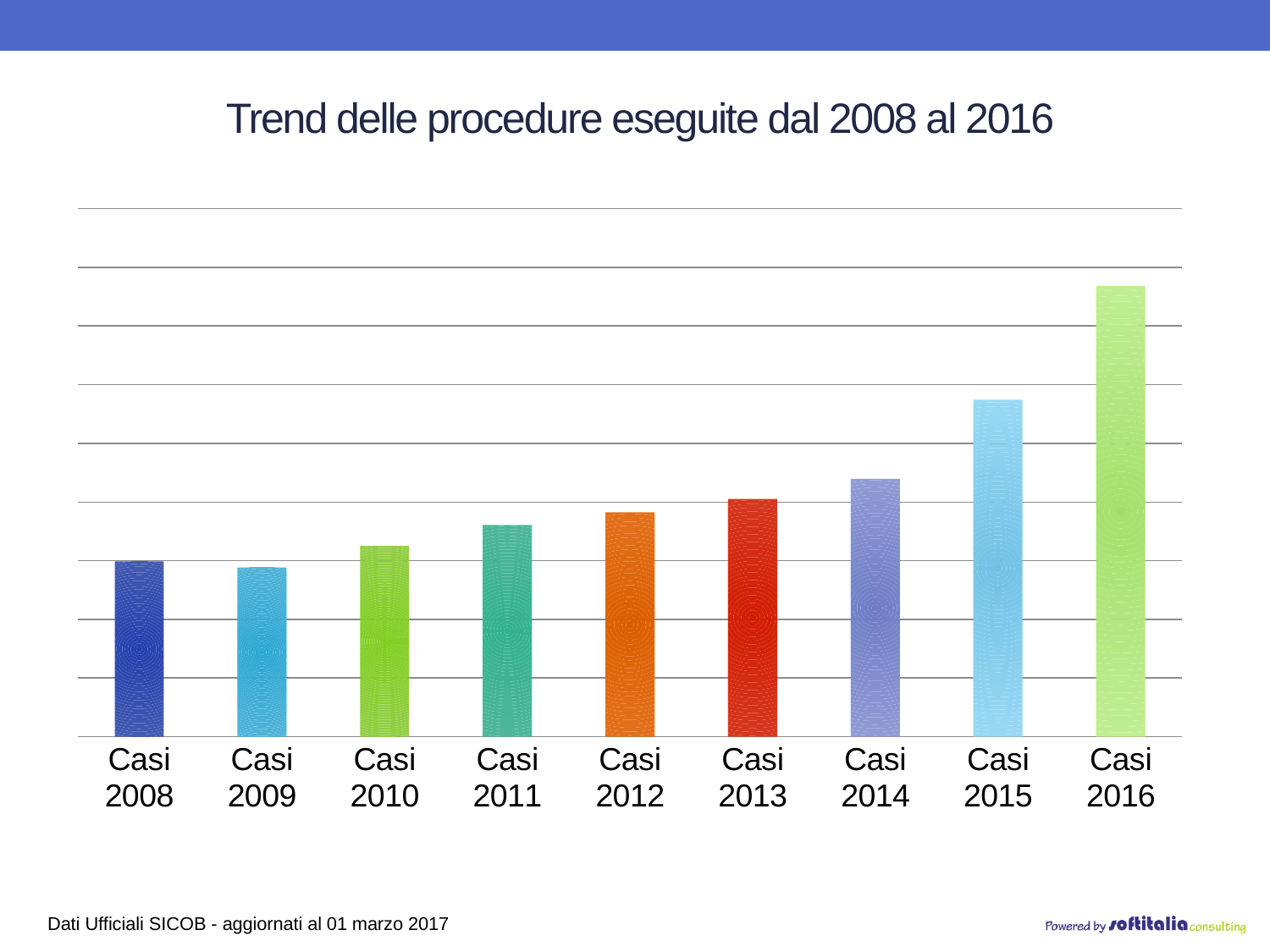
What kind of chart is shown on the slide? Bar chart Which category has the highest bar? Casi 2016 Which category has the second highest bar? Casi 2015 Which is larger, the value for Casi 2011 or the value for Casi 2015? Casi 2015 Do the values generally rise or fall from Casi 2009 to Casi 2016? Rise What data source is cited at the bottom of the slide? Dati Ufficiali SICOB - aggiornati al 01 marzo 2017 Which is larger, the value for Casi 2015 or the value for Casi 2014? Casi 2015 How many categories (years) are plotted on the x axis? 9 What is the title of the chart? Trend delle procedure eseguite dal 2008 al 2016 Which is larger, the value for Casi 2016 or the value for Casi 2013? Casi 2016